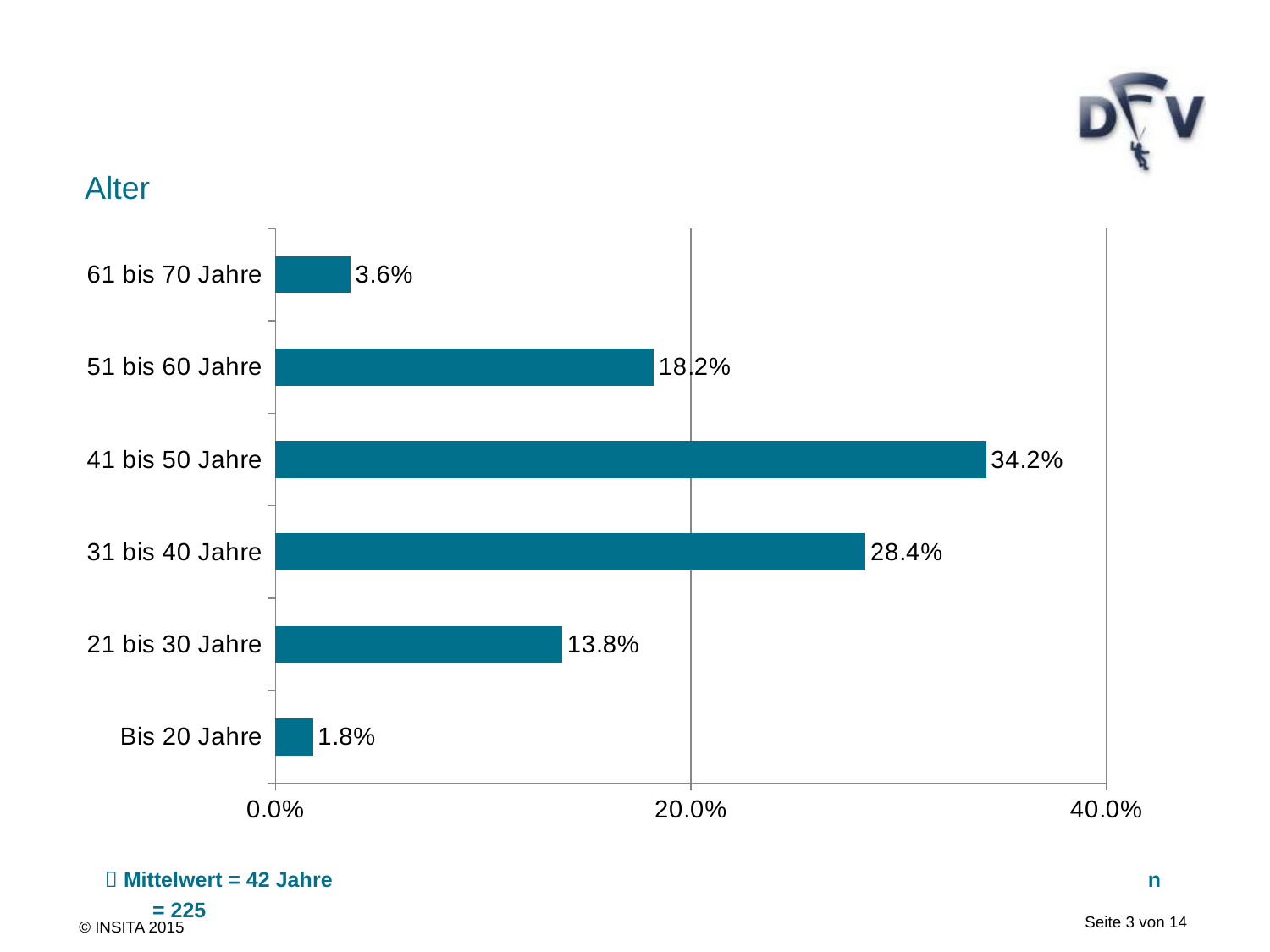
What is the difference between the values for 41 bis 50 Jahre and 31 bis 40 Jahre? 5.8% Is the value for 31 bis 40 Jahre greater or less than 20.0%? greater Which is larger, the value for 21 bis 30 Jahre or the value for 61 bis 70 Jahre? 21 bis 30 Jahre What is the title of the chart? Alter What is the difference between the values for 51 bis 60 Jahre and 21 bis 30 Jahre? 4.4% What kind of chart is shown on the slide? bar chart Which age group has the highest value? 41 bis 50 Jahre What is the value for Bis 20 Jahre? 1.8% What is the value for 41 bis 50 Jahre? 34.2% What is the value for 51 bis 60 Jahre? 18.2% Which age group has the lowest value? Bis 20 Jahre How many age categories are shown in the chart? 6